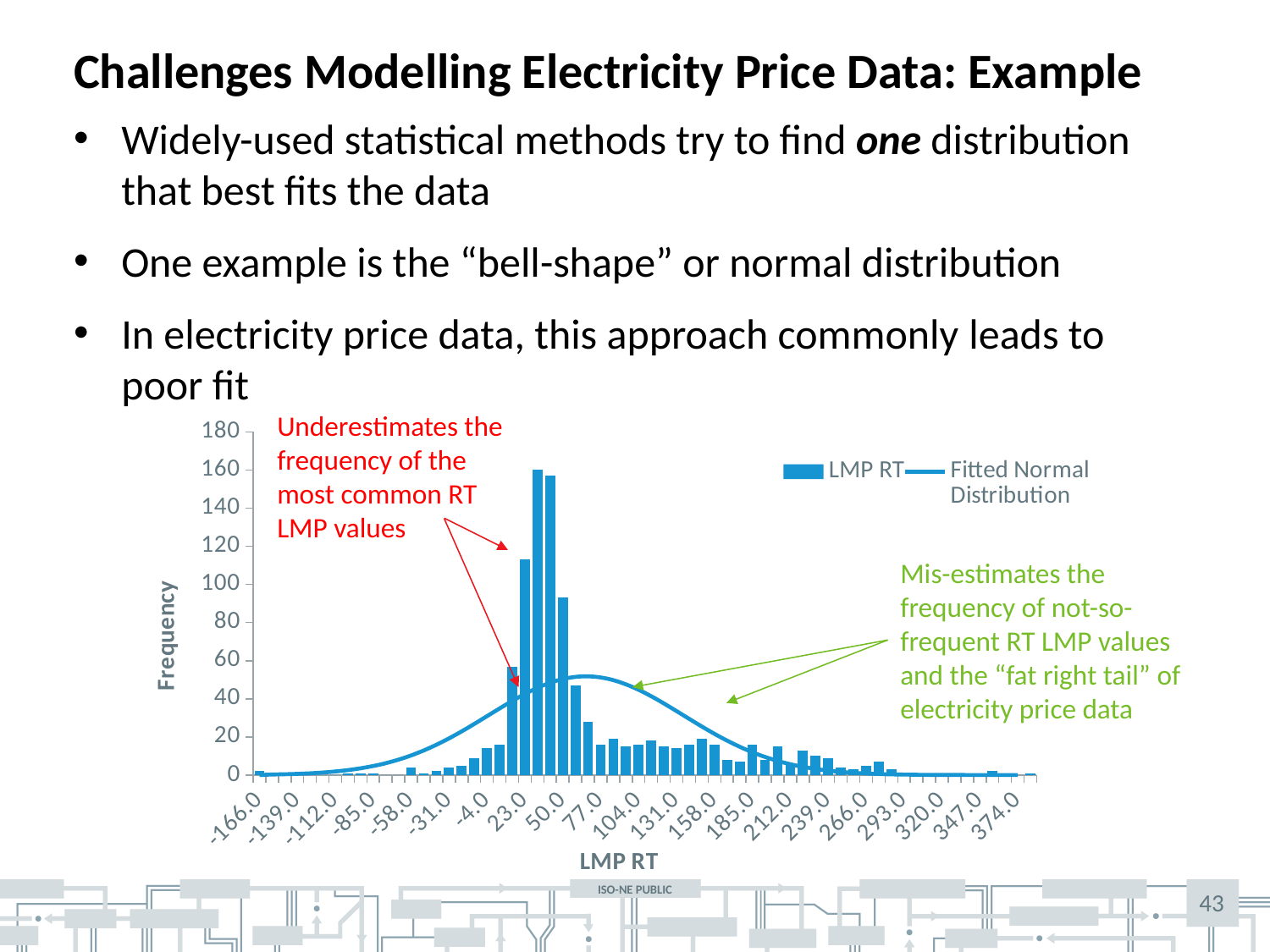
What is the title of the vertical axis of the chart? Frequency How many labelled tick marks are shown on the x axis of the chart? 21 Are the LMP RT bars near the x-axis label 374.0 greater or less than 20? less How many series does the chart legend list? 2 Between which two x-axis labels do the tallest LMP RT bars appear? 23.0 and 50.0 What are the two entries in the chart legend? LMP RT and Fitted Normal Distribution Which is higher: the tallest LMP RT bar or the peak of the Fitted Normal Distribution curve? the tallest LMP RT bar What is the highest value shown on the vertical axis of the chart? 180 Is the tallest LMP RT bar greater or less than 140? greater Is the peak of the Fitted Normal Distribution curve greater or less than 100? less What kind of chart is used to show the LMP RT frequencies on this slide? bar chart